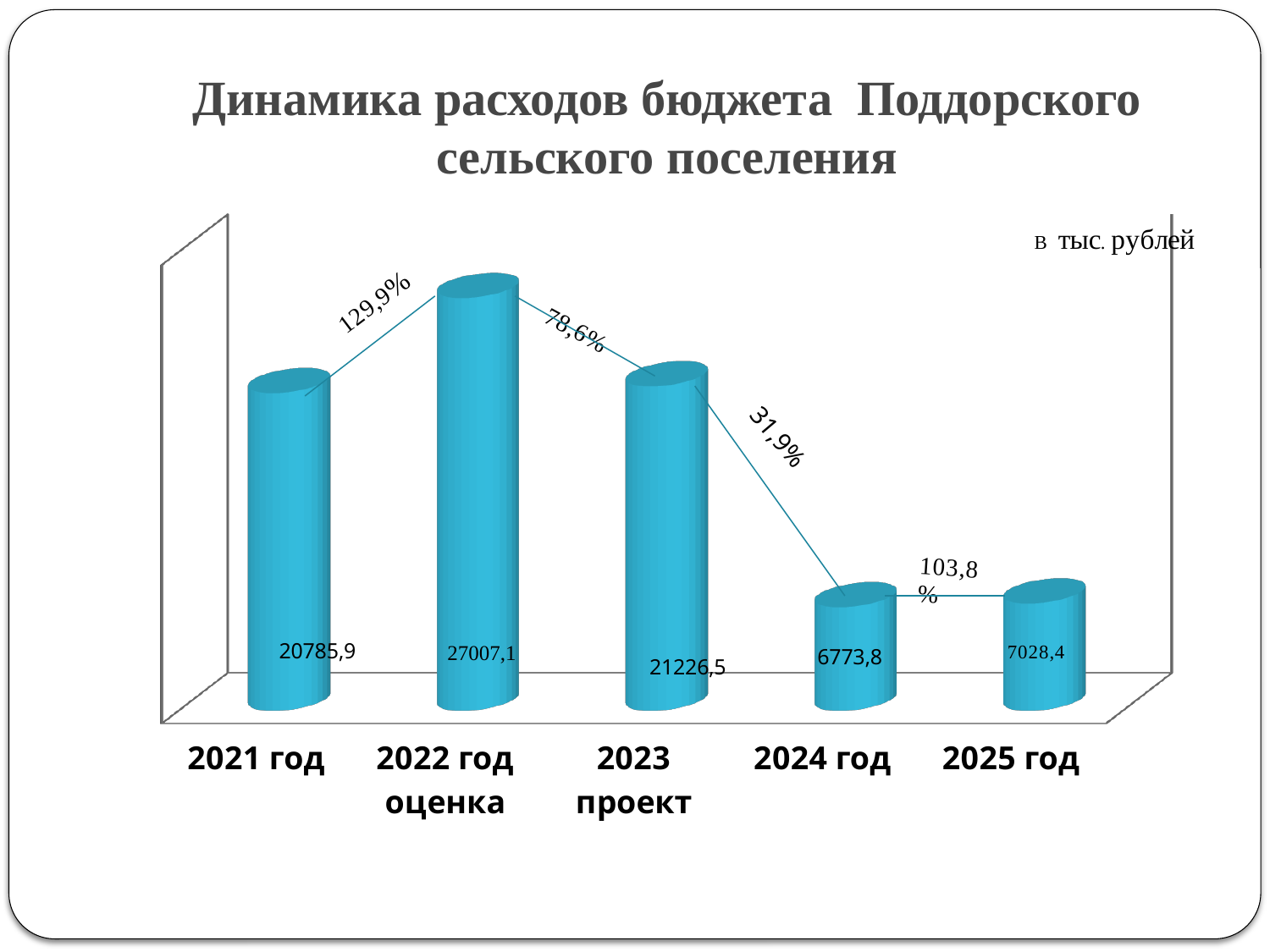
Which is larger, the value for 2023 проект or the value for 2021 год? 2023 проект What is the value for 2022 год оценка? 27007,1 What percentage label is shown between 2021 год and 2022 год оценка? 129,9% Which year has the highest value? 2022 год оценка What is the difference between the values for 2022 год оценка and 2021 год? 6221,2 What kind of chart is shown on the slide? bar chart How many years are shown on the chart? 5 What is the difference between the values for 2023 проект and 2024 год? 14452,7 What is the value for 2021 год? 20785,9 What is the value for 2024 год? 6773,8 What unit is indicated for the values on the chart? в тыс. рублей Which year has the lowest value? 2024 год